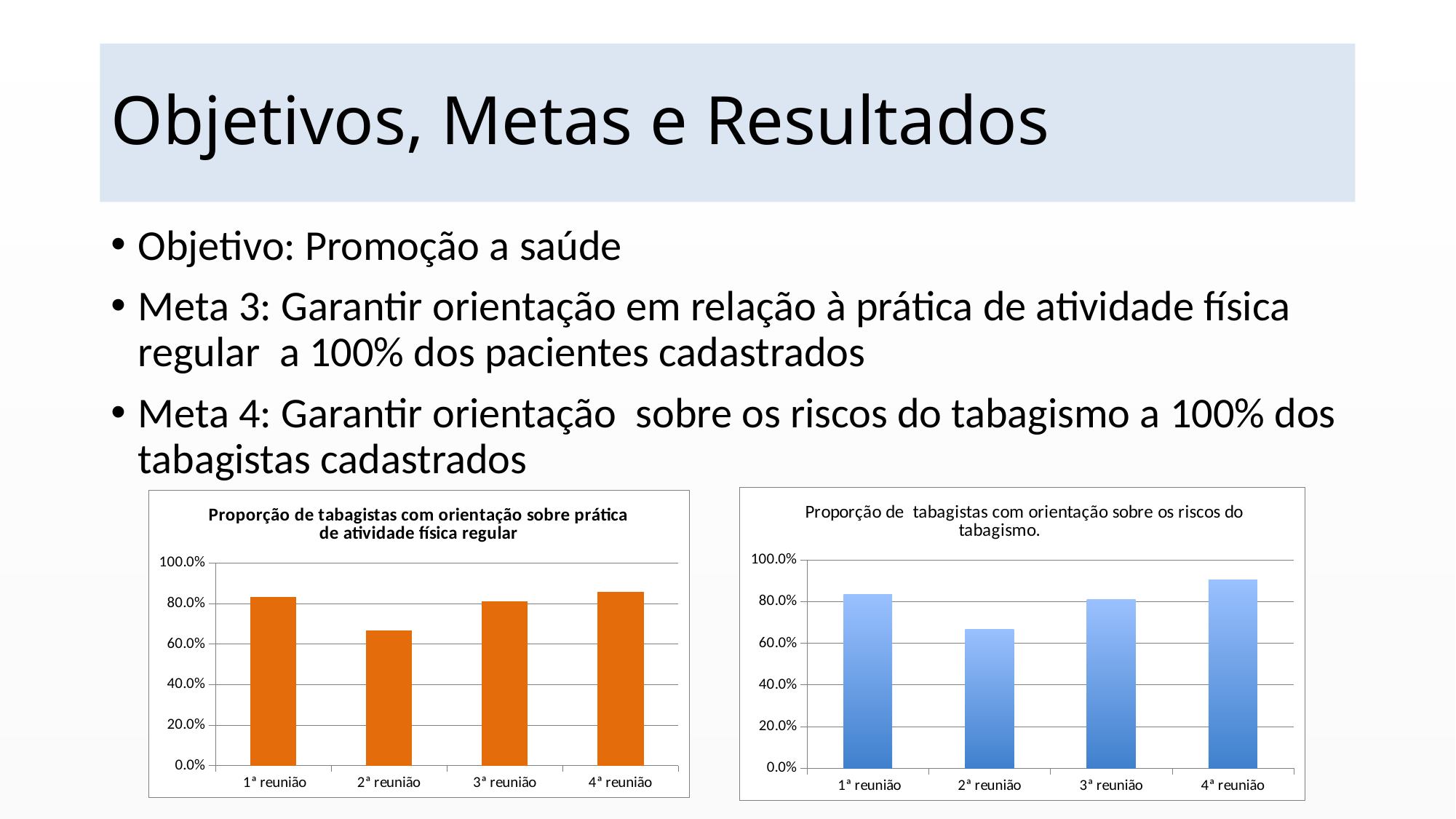
In the right chart, 'Proporção de tabagistas com orientação sobre os riscos do tabagismo', which category has the highest value? 4ª reunião In the right chart, 'Proporção de tabagistas com orientação sobre os riscos do tabagismo', is the value for 4ª reunião greater or less than 80.0%? greater In the left chart, 'Proporção de tabagistas com orientação sobre prática de atividade física regular', is the value for 2ª reunião greater or less than 60.0%? greater What colour are the bars in the right chart, 'Proporção de tabagistas com orientação sobre os riscos do tabagismo'? blue In the right chart, 'Proporção de tabagistas com orientação sobre os riscos do tabagismo', is the value for 2ª reunião greater or less than 80.0%? less In the left chart, 'Proporção de tabagistas com orientação sobre prática de atividade física regular', which is larger: the value for 1ª reunião or the value for 2ª reunião? 1ª reunião What kind of chart is the left chart, 'Proporção de tabagistas com orientação sobre prática de atividade física regular'? bar chart In the right chart, 'Proporção de tabagistas com orientação sobre os riscos do tabagismo', which category has the lowest value? 2ª reunião In the left chart, 'Proporção de tabagistas com orientação sobre prática de atividade física regular', which category has the lowest value? 2ª reunião How many categories are shown on the x axis of the right chart, 'Proporção de tabagistas com orientação sobre os riscos do tabagismo'? 4 In the right chart, 'Proporção de tabagistas com orientação sobre os riscos do tabagismo', which is larger: the value for 4ª reunião or the value for 2ª reunião? 4ª reunião